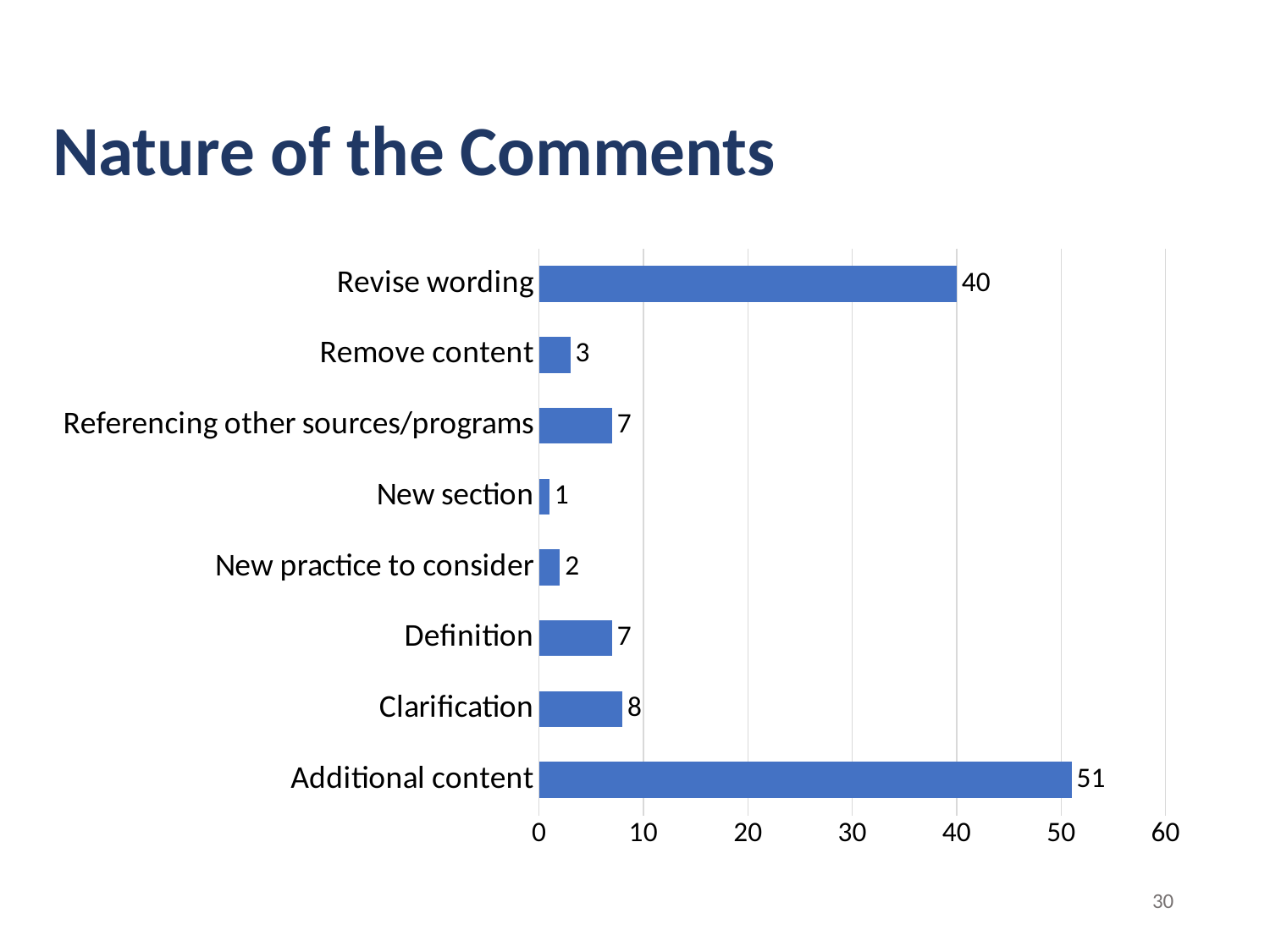
What kind of chart is shown on the slide? bar chart Is the value for Revise wording greater or less than 30? greater What is the value for Revise wording? 40 Which is larger, the value for Clarification or the value for Remove content? Clarification What is the value for New section? 1 What is the value for Clarification? 8 What is the value for Additional content? 51 Which category has the highest value? Additional content What is the difference between the values for Additional content and Revise wording? 11 What is the title of the slide? Nature of the Comments How many categories are shown in the chart? 8 Which category has the lowest value? New section